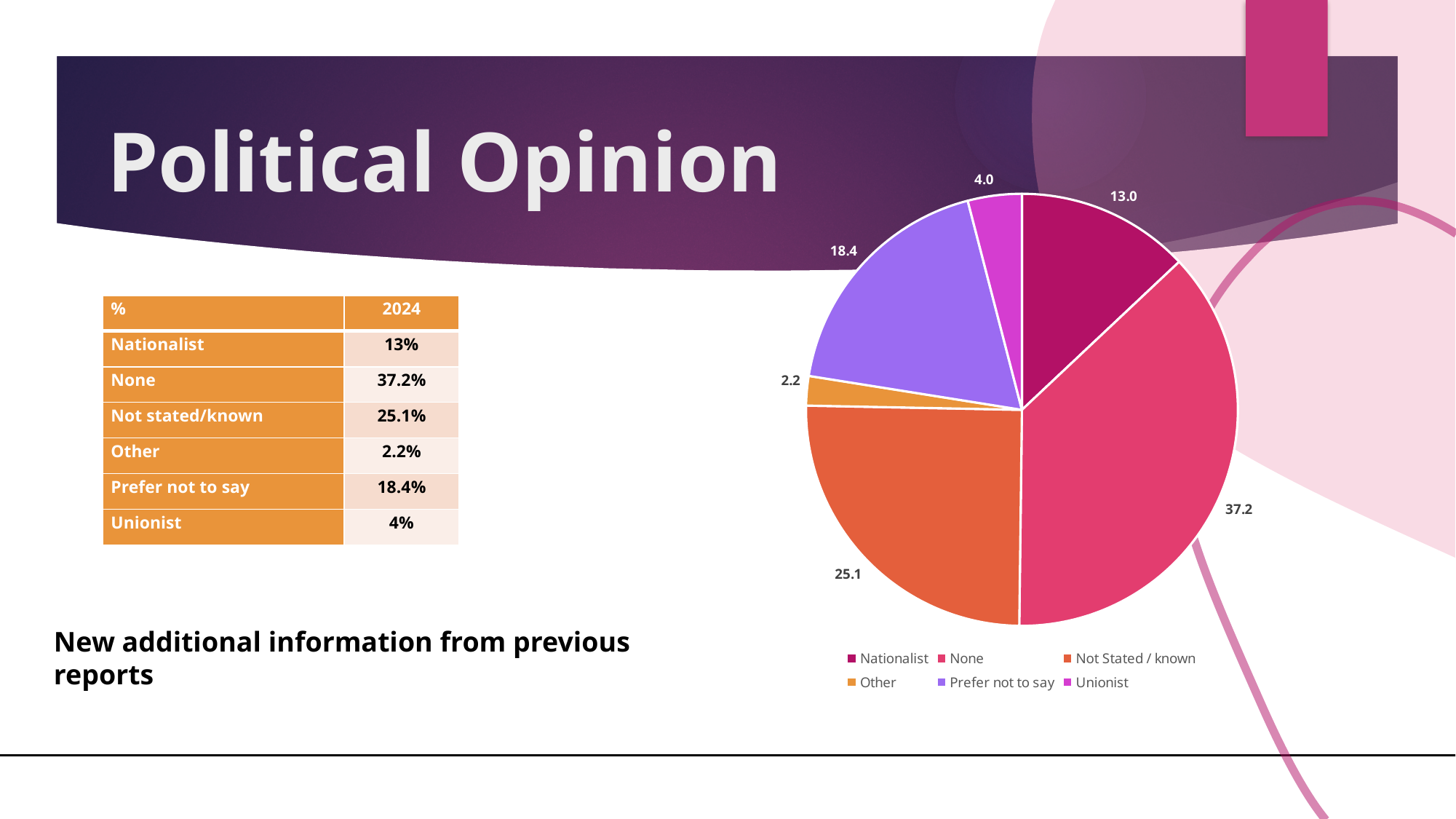
What type of chart is shown on the slide? pie chart How many entries does the pie chart legend list? 6 Which category has the largest slice in the pie chart? None Which is larger in the pie chart, the Nationalist slice or the Prefer not to say slice? Prefer not to say Which category has the smallest slice in the pie chart? Other What is the value shown for the Prefer not to say slice in the pie chart? 18.4 What is the value shown for the Nationalist slice in the pie chart? 13.0 How many slices does the pie chart have? 6 What is the difference between the None slice and the Not Stated / known slice in the pie chart? 12.1 What is the value shown for the None slice in the pie chart? 37.2 What colour is the Prefer not to say slice in the pie chart? purple What is the value shown for the Unionist slice in the pie chart? 4.0